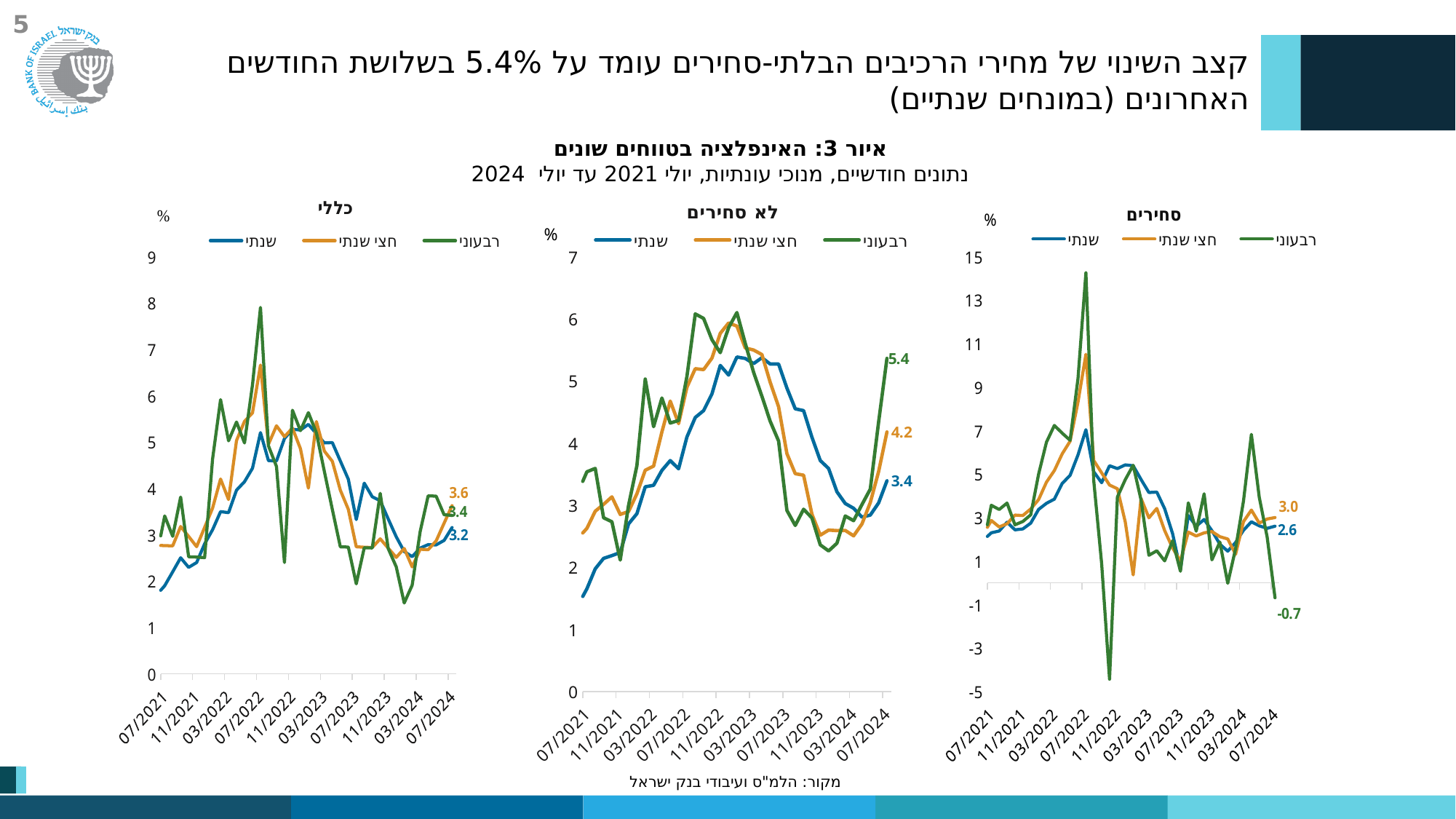
In the chart titled "סחירים", which series has the lowest final labelled value? רבעוני What kind of chart is the chart titled "סחירים"? line chart How many series does the legend of the chart titled "כללי" list? 3 In the chart titled "סחירים", what is the final labelled value of the חצי שנתי series? 3.0 In the chart titled "סחירים", is the peak value of the רבעוני series around 07/2022 greater or less than 13? greater In the chart titled "סחירים", what is the final labelled value of the רבעוני series? -0.7 In the chart titled "לא סחירים", what is the difference between the final labelled values of the רבעוני and שנתי series? 2.0 In the chart titled "כללי", what is the final labelled value of the חצי שנתי series? 3.6 In the chart titled "לא סחירים", what is the final labelled value of the חצי שנתי series? 4.2 In the chart titled "לא סחירים", what is the final labelled value of the רבעוני series at 07/2024? 5.4 In the chart titled "לא סחירים", what is the final labelled value of the שנתי series? 3.4 In the chart titled "כללי", what is the final labelled value of the שנתי series? 3.2